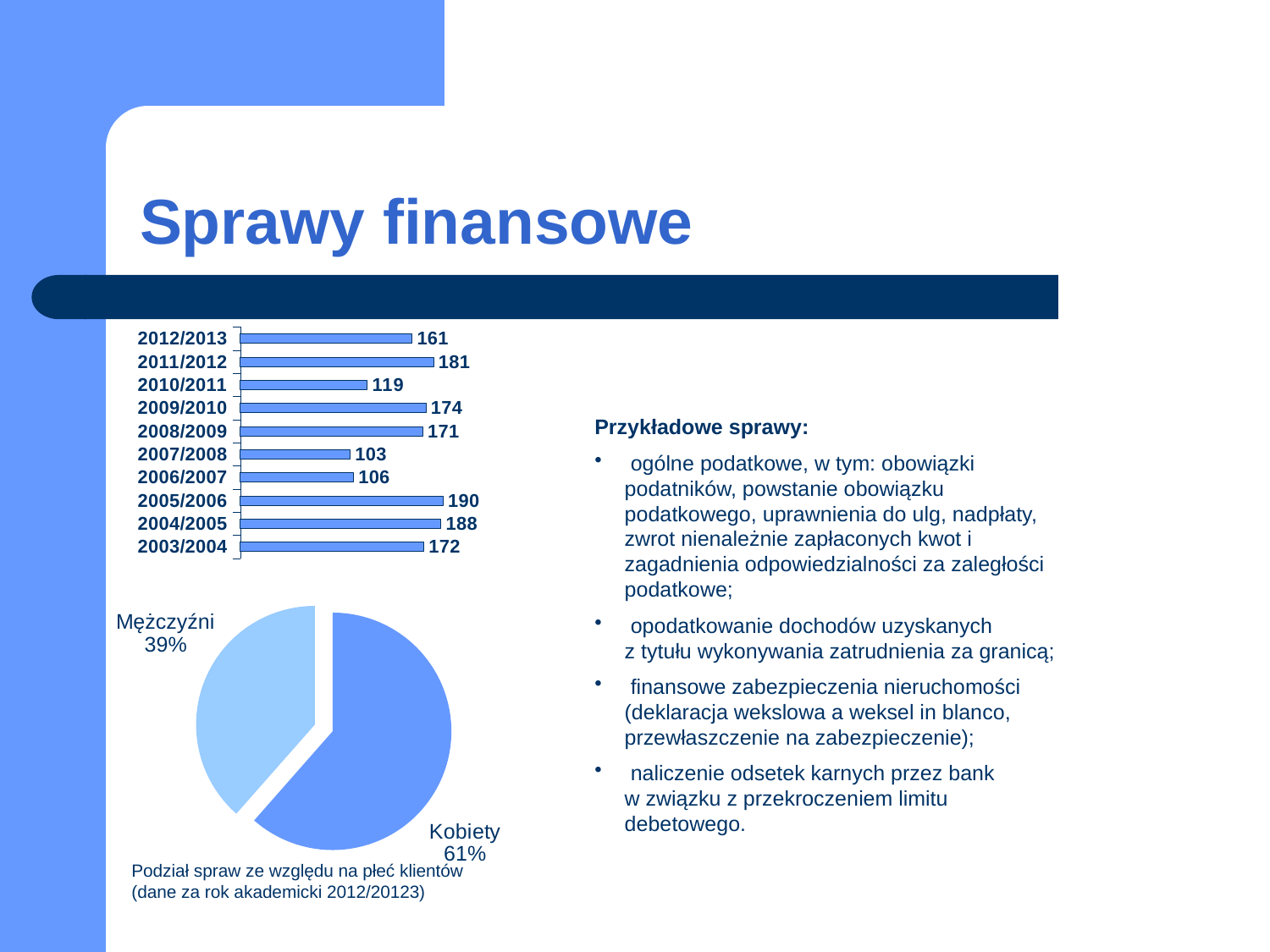
In the bar chart at the top left, which academic year has the highest value? 2005/2006 What kind of chart is shown at the top left of the slide? Bar chart What kind of chart is shown at the bottom left of the slide? Pie chart In the bar chart at the top left, which academic year has the lowest value? 2007/2008 In the bar chart at the top left, what is the difference between the values for 2005/2006 and 2007/2008? 87 In the bar chart at the top left, what is the difference between the values for 2011/2012 and 2010/2011? 62 In the pie chart at the bottom left, what share is labelled Kobiety? 61% In the bar chart at the top left, which is larger: the value for 2009/2010 or the value for 2008/2009? 2009/2010 In the bar chart at the top left, what is the value for 2012/2013? 161 In the bar chart at the top left, how many academic years are shown? 10 In the pie chart at the bottom left, what share is labelled Mężczyźni? 39% In the bar chart at the top left, what is the value for 2010/2011? 119